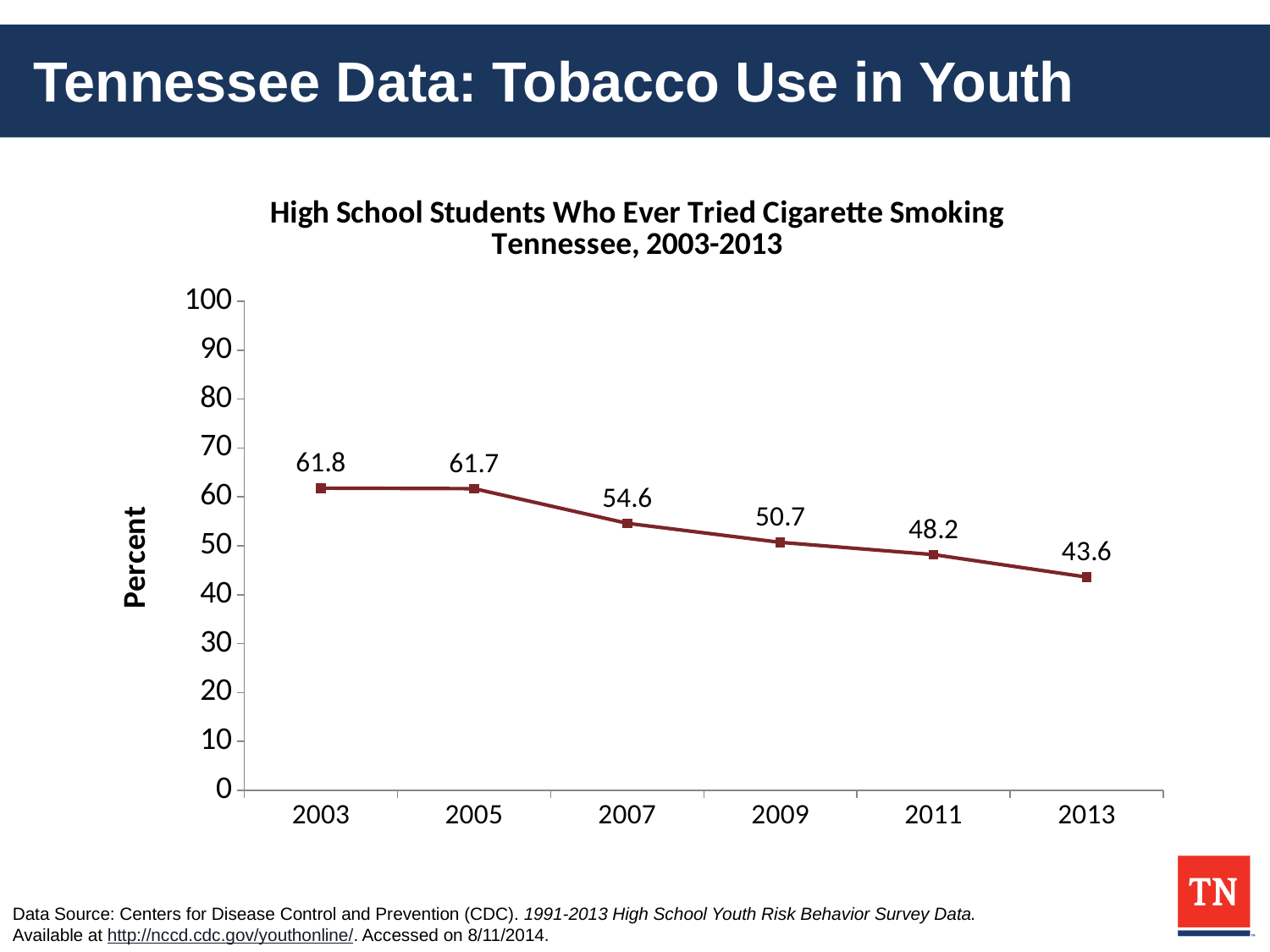
Do the values rise or fall from 2003 to 2013? Fall What is the value plotted for 2013? 43.6 Which year has the highest value on the chart? 2003 What kind of chart is shown on the slide? Line chart What is the value plotted for 2009? 50.7 What percent of high school students had ever tried cigarette smoking in 2003? 61.8 Which year has the lowest value on the chart? 2013 How many data points are plotted on the chart? 6 What is the difference between the 2007 value and the 2011 value? 6.4 What is the label on the vertical axis of the chart? Percent Which year has a larger value, 2007 or 2011? 2007 What is the difference between the 2003 value and the 2013 value? 18.2